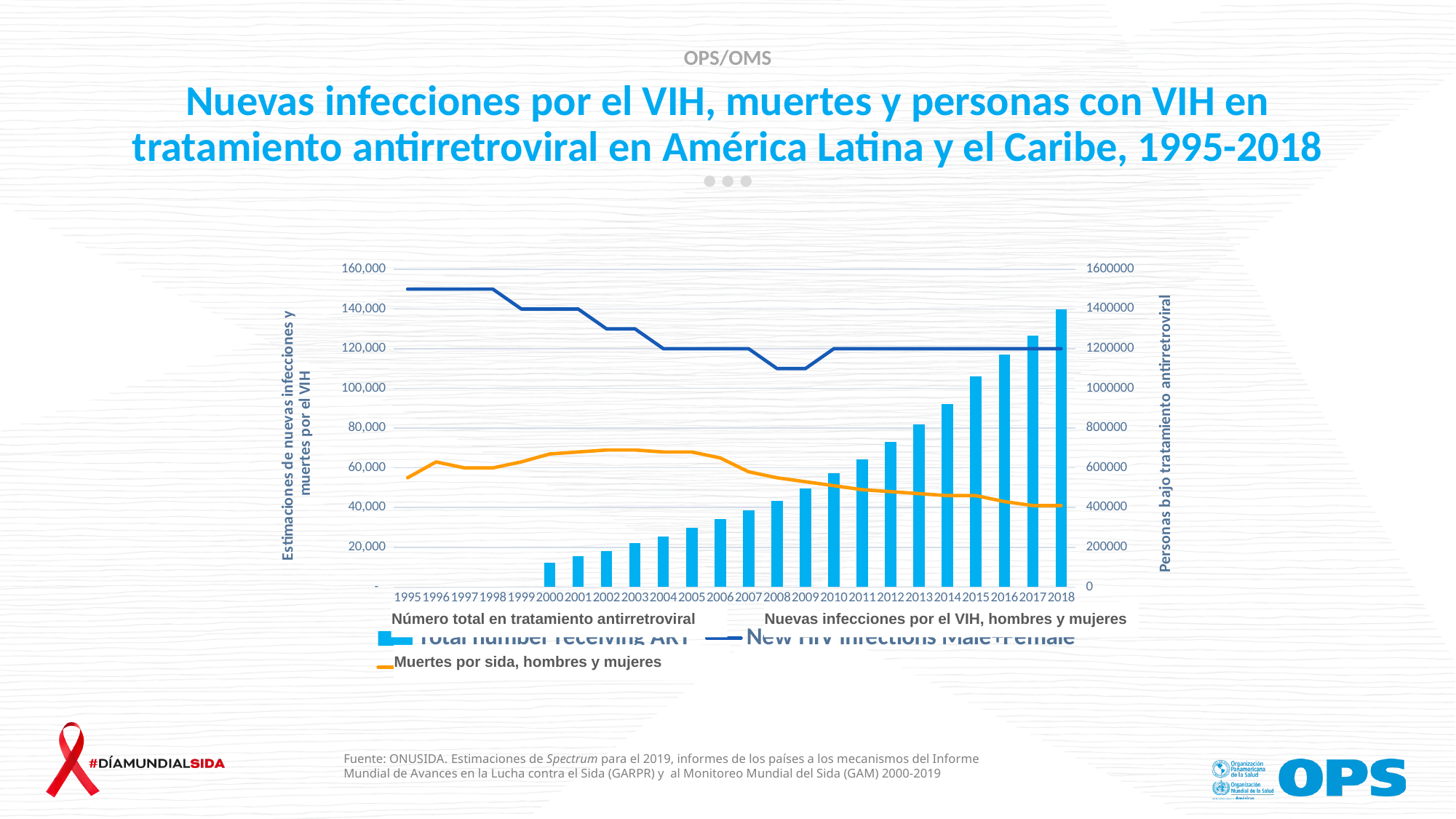
How many series does the legend list? 3 How many years are shown on the x axis? 24 Is the value for new HIV infections in 2008 greater or less than 120,000? less Which colour is used for the 'Muertes por sida, hombres y mujeres' line? Orange Is the value for new HIV infections in 1995 greater or less than 140,000? greater Is the total number receiving ART in 2010 greater or less than 800000? less In which year is the bar for total number receiving ART the lowest? 2000 What kind of chart is shown on the slide? A combination bar and line chart In which year is the bar for total number receiving ART the highest? 2018 Do the bars for total number receiving ART rise or fall from 2000 to 2018? rise